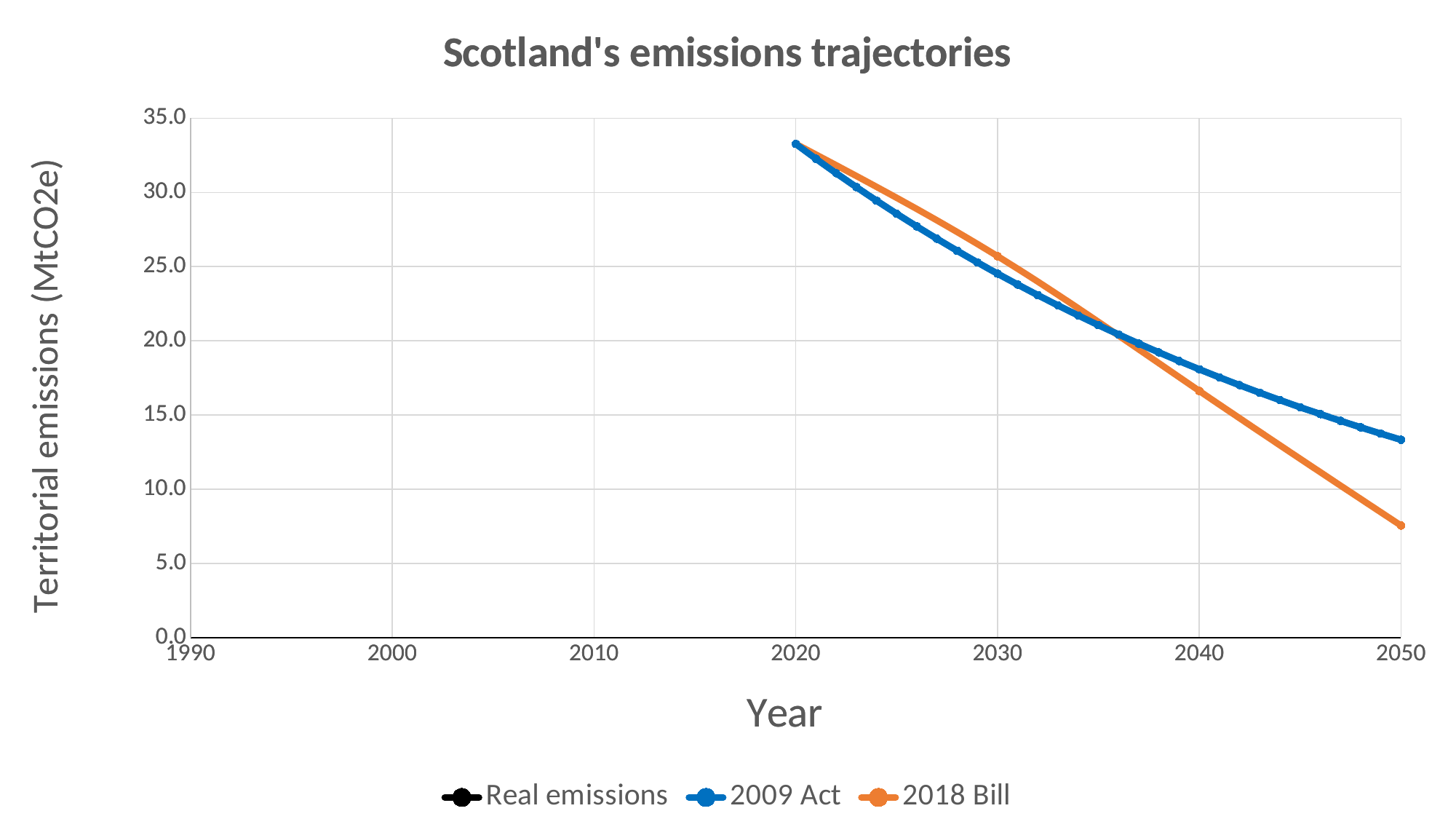
What is the title of the chart? Scotland's emissions trajectories Is the value for the 2009 Act series in 2050 greater or less than 15.0? less Do the values of the 2009 Act series rise or fall from 2020 to 2050? fall What kind of chart is shown on the slide? line chart In 2030, which series has the higher value, 2009 Act or 2018 Bill? 2018 Bill What is the label of the vertical axis? Territorial emissions (MtCO2e) Is the value for the 2009 Act series in 2030 greater or less than 20.0? greater How many series does the legend list? 3 Do the values of the 2018 Bill series rise or fall from 2020 to 2050? fall Is the value for the 2018 Bill series in 2050 greater or less than 10.0? less In 2050, which series has the higher value, 2009 Act or 2018 Bill? 2009 Act